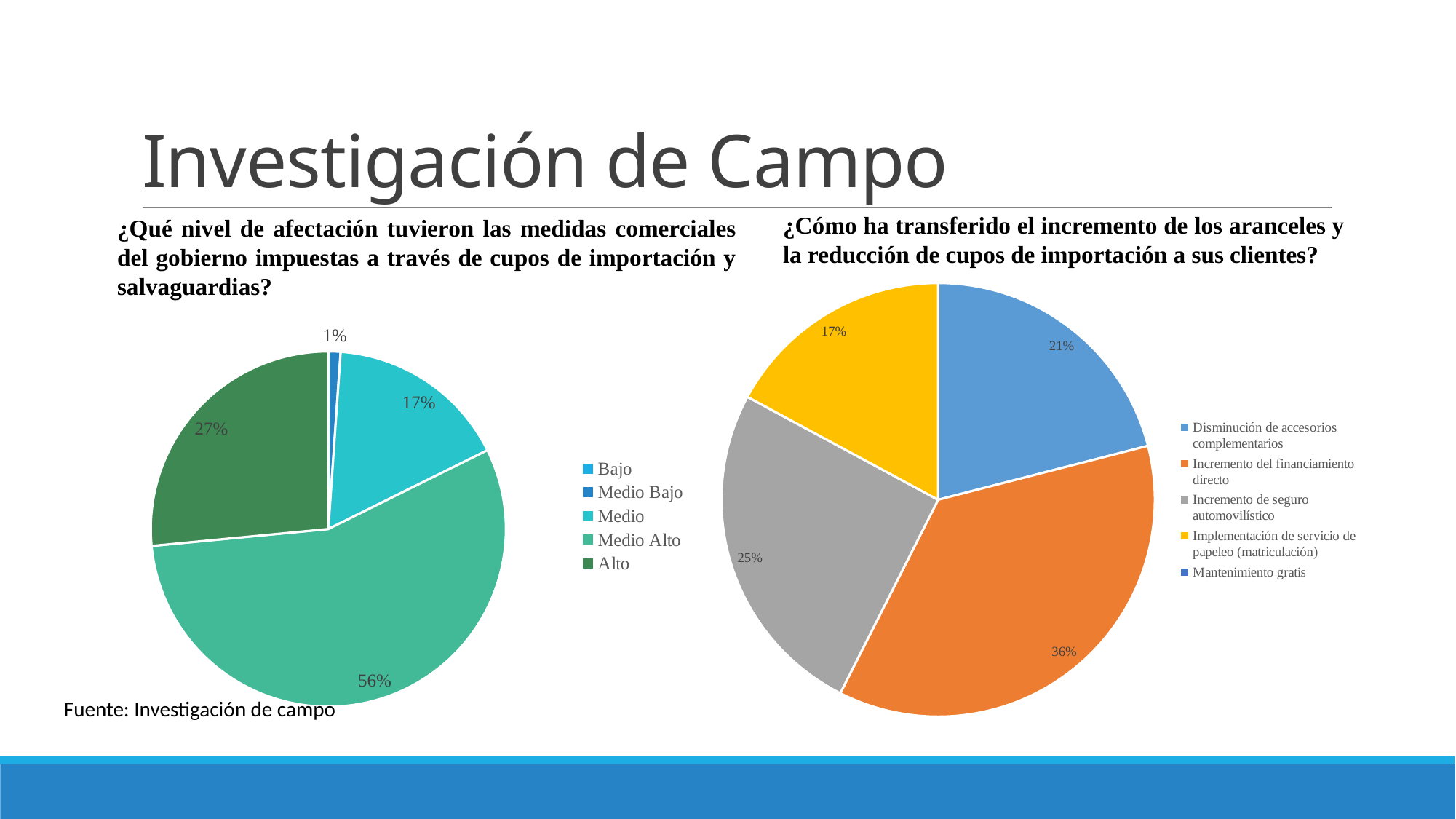
In the right pie chart (¿Cómo ha transferido el incremento...?), which category has the largest slice? Incremento del financiamiento directo In the left pie chart (¿Qué nivel de afectación...?), what percentage is shown for Medio? 17% In the left pie chart (¿Qué nivel de afectación...?), what percentage is shown for Alto? 27% In the right pie chart (¿Cómo ha transferido el incremento...?), what percentage is shown for Incremento del financiamiento directo? 36% In the right pie chart (¿Cómo ha transferido el incremento...?), what percentage is shown for Incremento de seguro automovilístico? 25% In the left pie chart (¿Qué nivel de afectación...?), how many categories does the legend list? 5 In the left pie chart (¿Qué nivel de afectación...?), which category has the largest slice? Medio Alto In the right pie chart (¿Cómo ha transferido el incremento...?), which is larger: Disminución de accesorios complementarios or Implementación de servicio de papeleo (matriculación)? Disminución de accesorios complementarios In the right pie chart (¿Cómo ha transferido el incremento...?), what percentage is shown for Disminución de accesorios complementarios? 21% In the left pie chart (¿Qué nivel de afectación...?), what is the difference in percentage points between Medio Alto and Alto? 29 What type of chart is used for both charts on the slide? Pie chart In the left pie chart (¿Qué nivel de afectación...?), what percentage is shown for Medio Alto? 56%